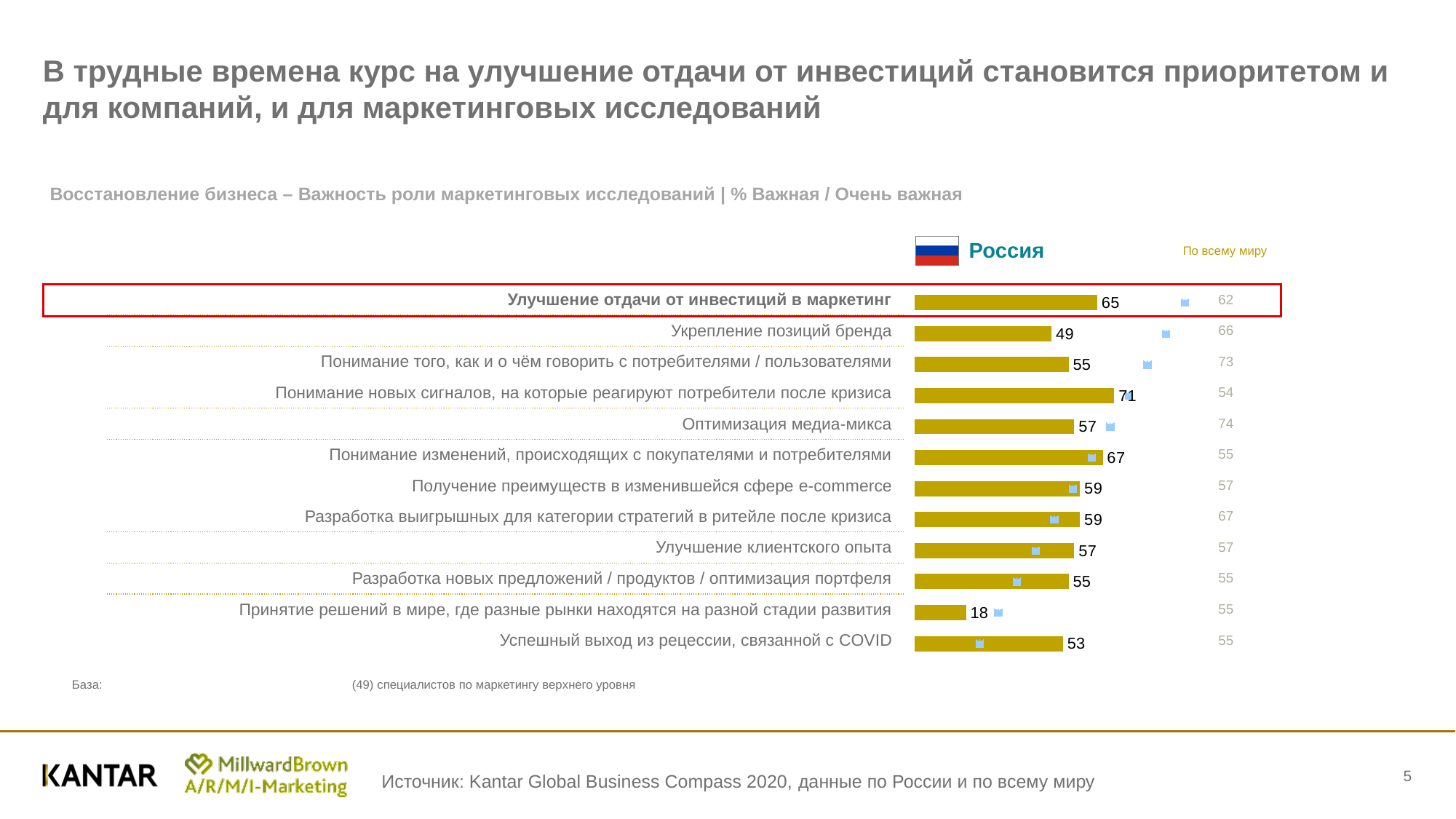
Что больше: значение для России по категории «Понимание изменений, происходящих с покупателями и потребителями» или по категории «Успешный выход из рецессии, связанной с COVID»? Понимание изменений, происходящих с покупателями и потребителями Какая категория выделена красной рамкой на диаграмме? Улучшение отдачи от инвестиций в маркетинг Что больше для категории «Укрепление позиций бренда»: значение для России или значение «По всему миру»? По всему миру Какое значение для России показано для категории «Улучшение отдачи от инвестиций в маркетинг»? 65 Какая категория имеет наибольшее значение для России? Понимание новых сигналов, на которые реагируют потребители после кризиса Какое значение «По всему миру» указано для категории «Оптимизация медиа-микса»? 74 Какого типа эта диаграмма? Столбчатая (bar chart) с горизонтальными полосами Какое значение для России показано для категории «Принятие решений в мире, где разные рынки находятся на разной стадии развития»? 18 Сколько категорий показано на диаграмме? 12 Какая категория имеет наибольшее значение «По всему миру»? Оптимизация медиа-микса На сколько значение для России по категории «Понимание новых сигналов, на которые реагируют потребители после кризиса» больше значения «По всему миру» по той же категории? 17 Какая категория имеет наименьшее значение для России? Принятие решений в мире, где разные рынки находятся на разной стадии развития